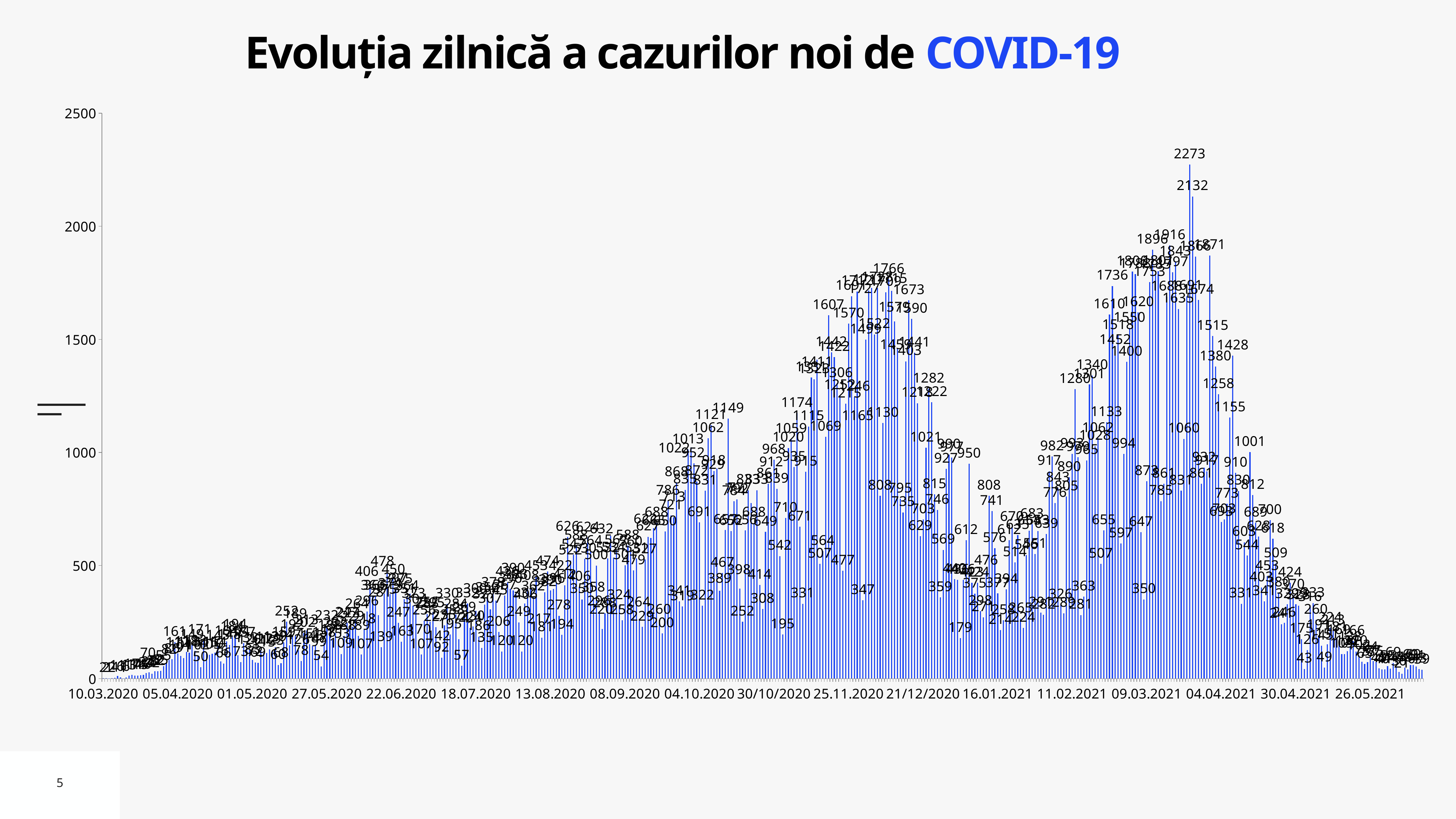
What is the highest tick value shown on the vertical axis? 2500 Do the daily values rise or fall between 04.04.2021 and 26.05.2021? fall What is the first date label shown on the horizontal axis? 10.03.2020 What is the highest labelled value of the wave peaking around 25.11.2020? 1766 What is the second-highest daily value labelled on the chart, next to the 2273 peak? 2132 Is the highest bar on the chart greater or less than 2000? greater Is the peak of the wave around 25.11.2020 greater or less than 2000? less What is the title of the chart? Evoluția zilnică a cazurilor noi de COVID-19 What is the highest daily value labelled on the chart? 2273 What kind of chart is shown on the slide? bar chart What is the difference between the two highest labelled values, 2273 and 2132? 141 Which is larger: the peak of the wave around 25.11.2020 (1766) or the peak of the wave around 04.04.2021 (2273)? 2273 (around 04.04.2021)